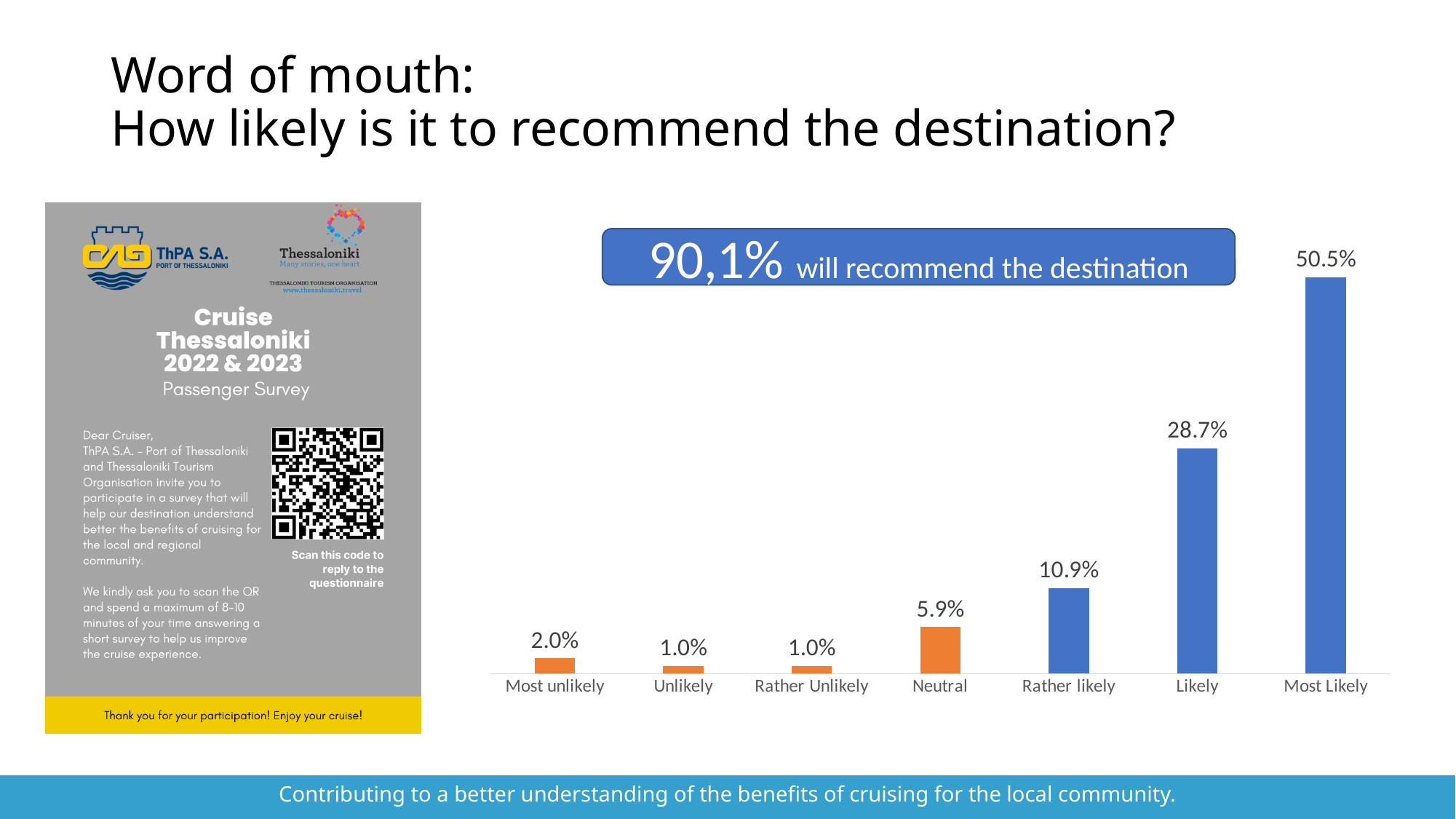
What is the value for Rather likely? 10.9% Which is larger, the value for Most unlikely or the value for Neutral? Neutral Which category has the highest value? Most Likely What kind of chart is shown on the slide? bar chart What is the difference between the values for Most Likely and Likely? 21.8% What is the value for Most Likely? 50.5% What is the total of the values for Rather likely, Likely and Most Likely? 90.1% What is the value for Neutral? 5.9% How many categories are shown on the x axis? 7 What colour are the bars for Rather likely, Likely and Most Likely? blue Do the values generally rise or fall from Neutral to Most Likely along the x axis? rise What is the difference between the values for Rather likely and Neutral? 5.0%